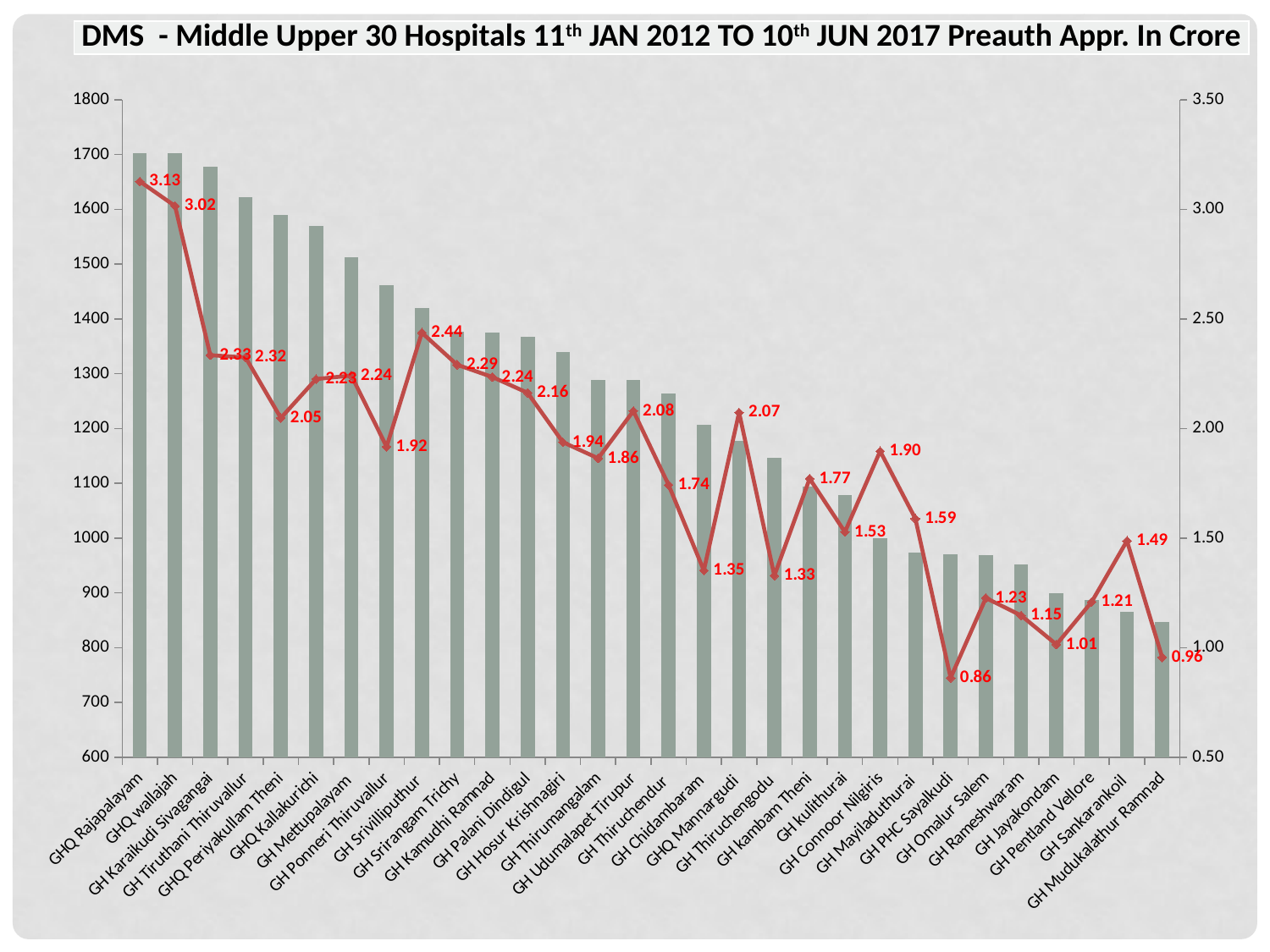
What is the line value (in crore) for GH PHC Sayalkudi? 0.86 How many hospitals are shown on the x axis? 30 Is the bar value for GH Mudukalathur Ramnad greater or less than 900? less Which has a larger line value, GH Chidambaram or GHQ Mannargudi? GHQ Mannargudi What is the line value (in crore) for GHQ Rajapalayam? 3.13 What is the line value (in crore) for GH Sankarankoil? 1.49 Which hospital has the highest line value (in crore)? GHQ Rajapalayam What is the difference between the line values for GHQ Rajapalayam and GHQ wallajah? 0.11 Is the bar value for GH Srivilliputhur greater or less than 1400? greater What kind of chart is this? Combination bar and line chart Which hospital has the lowest line value (in crore)? GH PHC Sayalkudi What is the line value (in crore) for GH Srivilliputhur? 2.44